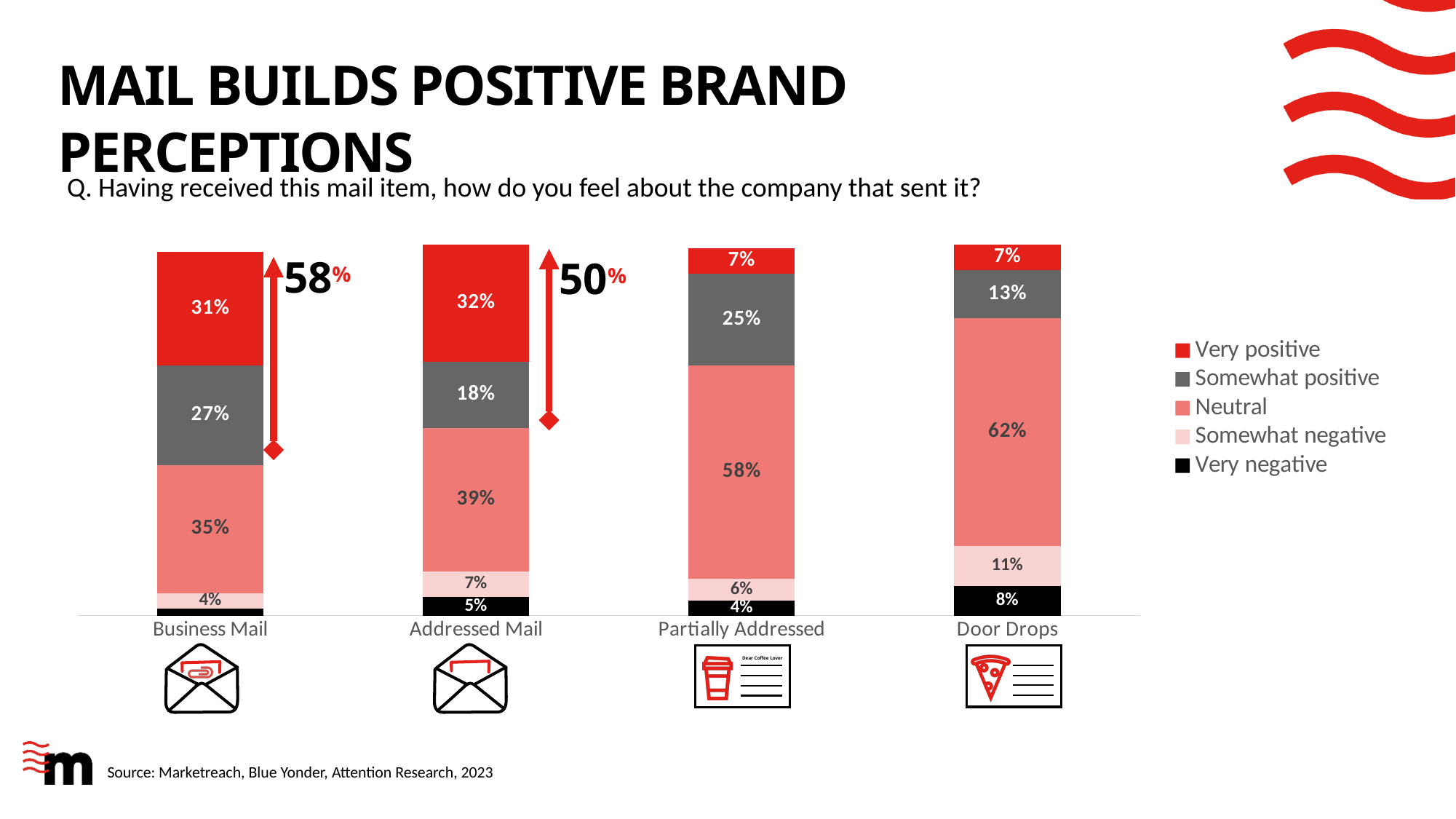
How much higher is the Somewhat positive value for Business Mail than for Addressed Mail? 9% What combined positive percentage is annotated next to the Business Mail bar? 58% How many mail types are shown on the x axis? 4 What percentage of respondents felt Very positive about the company after receiving Addressed Mail? 32% What is the Somewhat negative value for Door Drops? 11% What kind of chart is shown on the slide? Stacked bar chart Which mail type has the highest Very positive percentage? Addressed Mail Which has a larger Very negative share, Door Drops or Addressed Mail? Door Drops What is the Somewhat positive value for Partially Addressed mail? 25% What is the Neutral share for Door Drops? 62% How many series does the legend list? 5 Which mail type has the lowest Neutral percentage? Business Mail